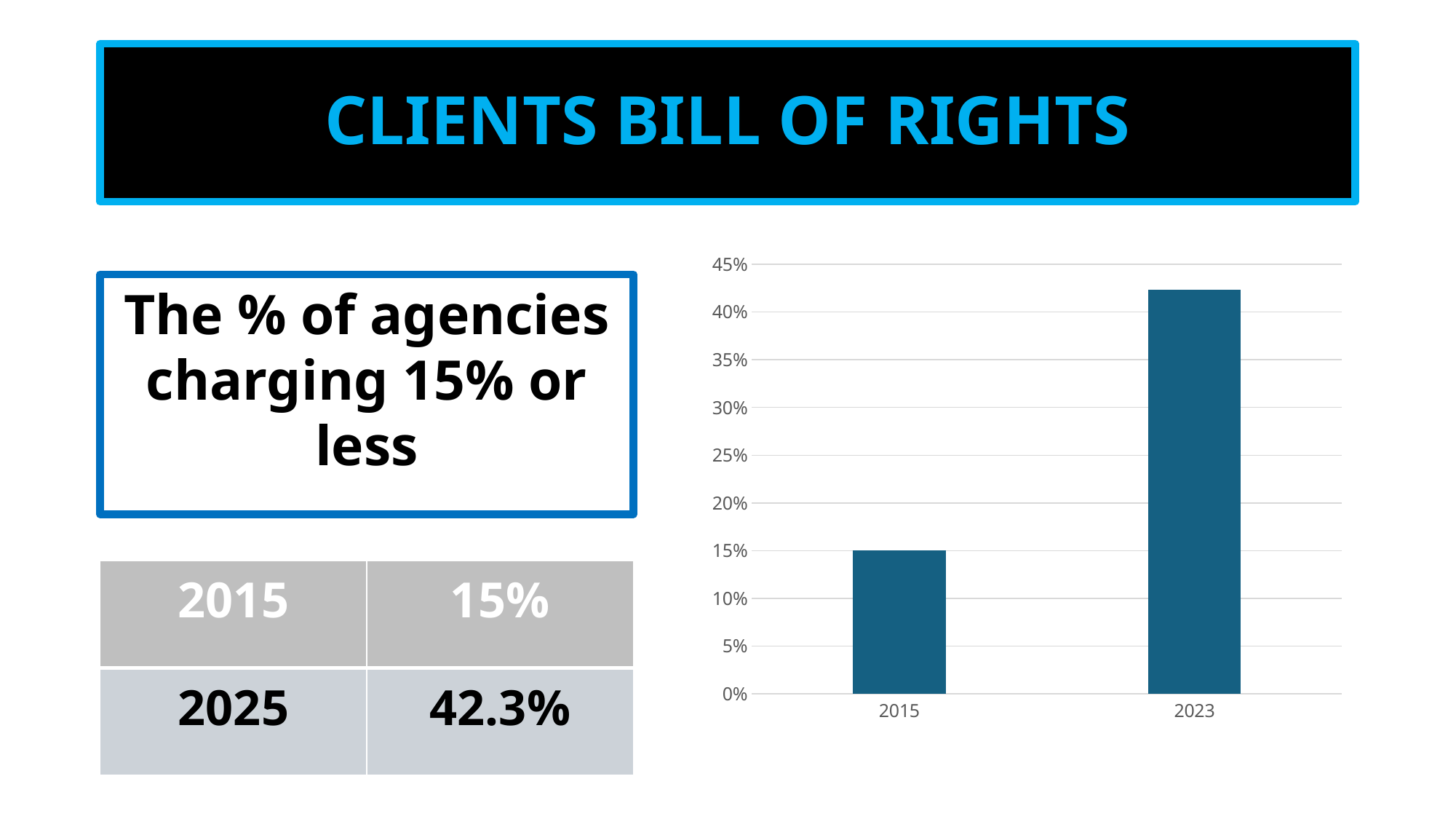
Is the value for 2023 greater or less than 40%? greater Is the value for 2015 greater or less than 20%? less Do the values rise or fall from 2015 to 2023? rise Which year has the lowest bar? 2015 What kind of chart is shown on the slide? bar chart How many bars does the chart have? 2 Is the value for 2023 greater or less than 45%? less What is the value of the bar for 2015? 15% What are the two category labels on the horizontal axis? 2015 and 2023 Which bar is taller, 2015 or 2023? 2023 Which year has the highest bar? 2023 What is the highest value shown on the vertical axis? 45%